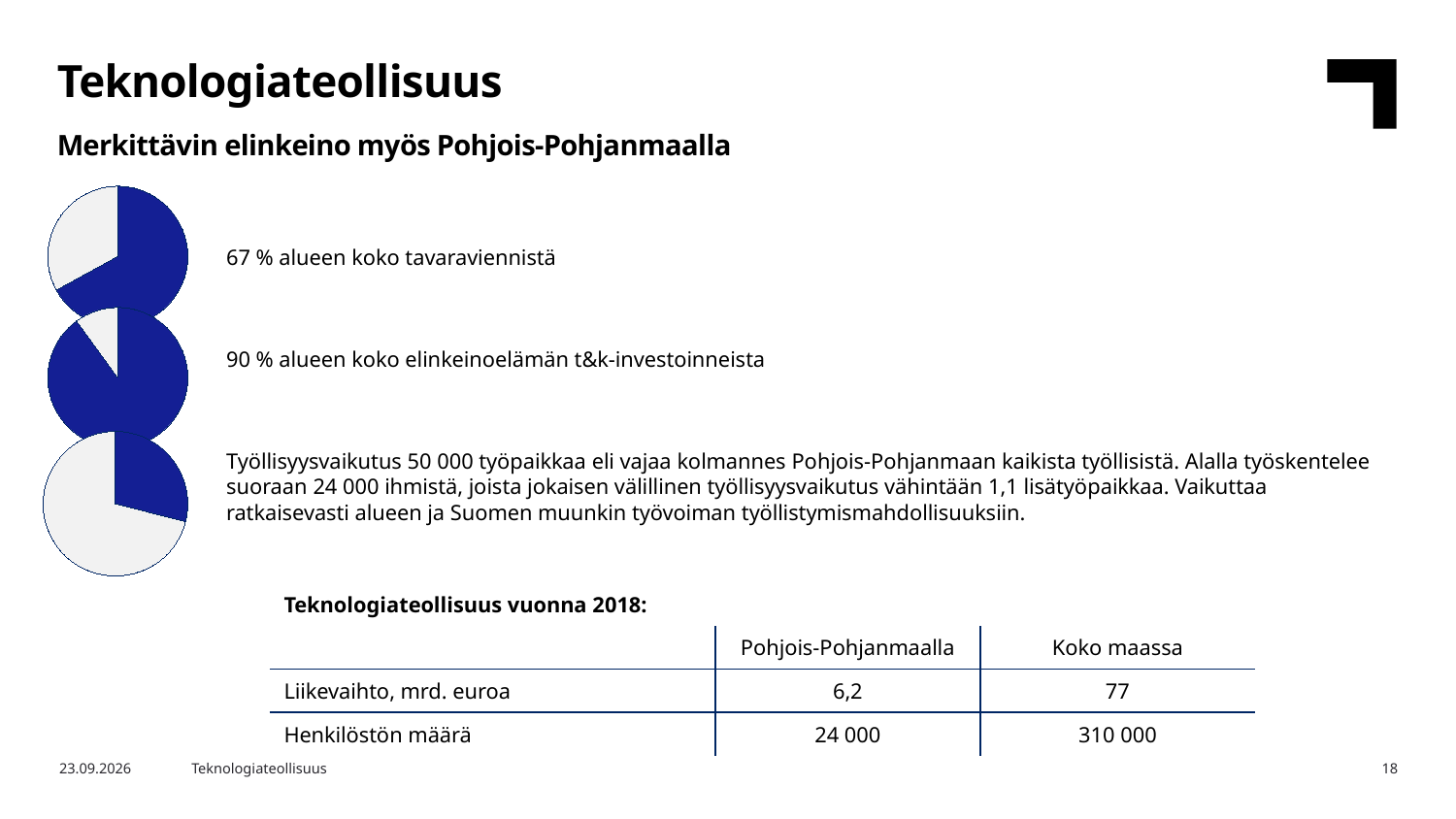
Is the blue slice larger in the top pie chart or in the middle pie chart? Middle pie chart What is the difference in percentage points between the shares shown by the middle pie chart (90 %) and the top pie chart (67 %)? 23 percentage points Which of the three pie charts has the smallest blue slice? The bottom pie chart What share of the region's total goods exports does the top pie chart represent, according to the text beside it? 67 % What share of the region's business R&D investments does the middle pie chart represent, according to the text beside it? 90 % What two colours are used in the pie charts? Blue and light grey Which of the three pie charts has the largest blue slice? The middle pie chart (90 %) How many pie charts are on the slide? 3 What is the title of the slide containing the pie charts? Teknologiateollisuus In the bottom pie chart, is the blue slice or the grey slice larger? Grey slice How many slices does each pie chart have? 2 What kind of charts are shown on the left side of the slide? Pie charts